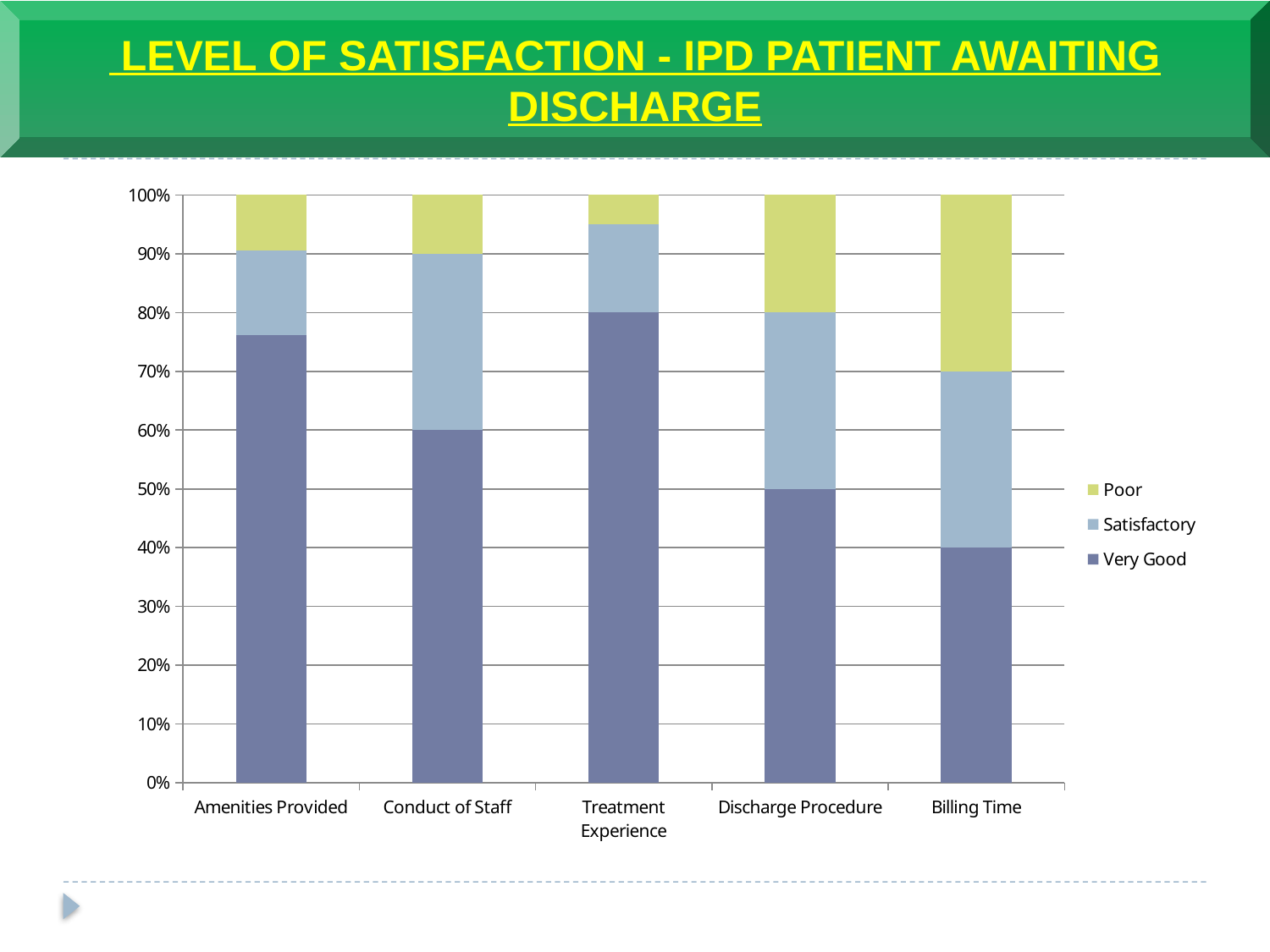
What is the Very Good value for Discharge Procedure? 50% Which category has the lowest Very Good share? Billing Time How many categories are shown on the x axis? 5 Which is larger, the Very Good share for Conduct of Staff or for Discharge Procedure? Conduct of Staff What kind of chart is shown on the slide? Stacked bar chart Which category has the largest Poor share? Billing Time What is the Very Good value for Billing Time? 40% How many series does the legend list? 3 What is the Very Good value for Conduct of Staff? 60% Which category has the highest Very Good share? Treatment Experience What is the Very Good value for Treatment Experience? 80% Is the Very Good value for Amenities Provided greater or less than 70%? greater